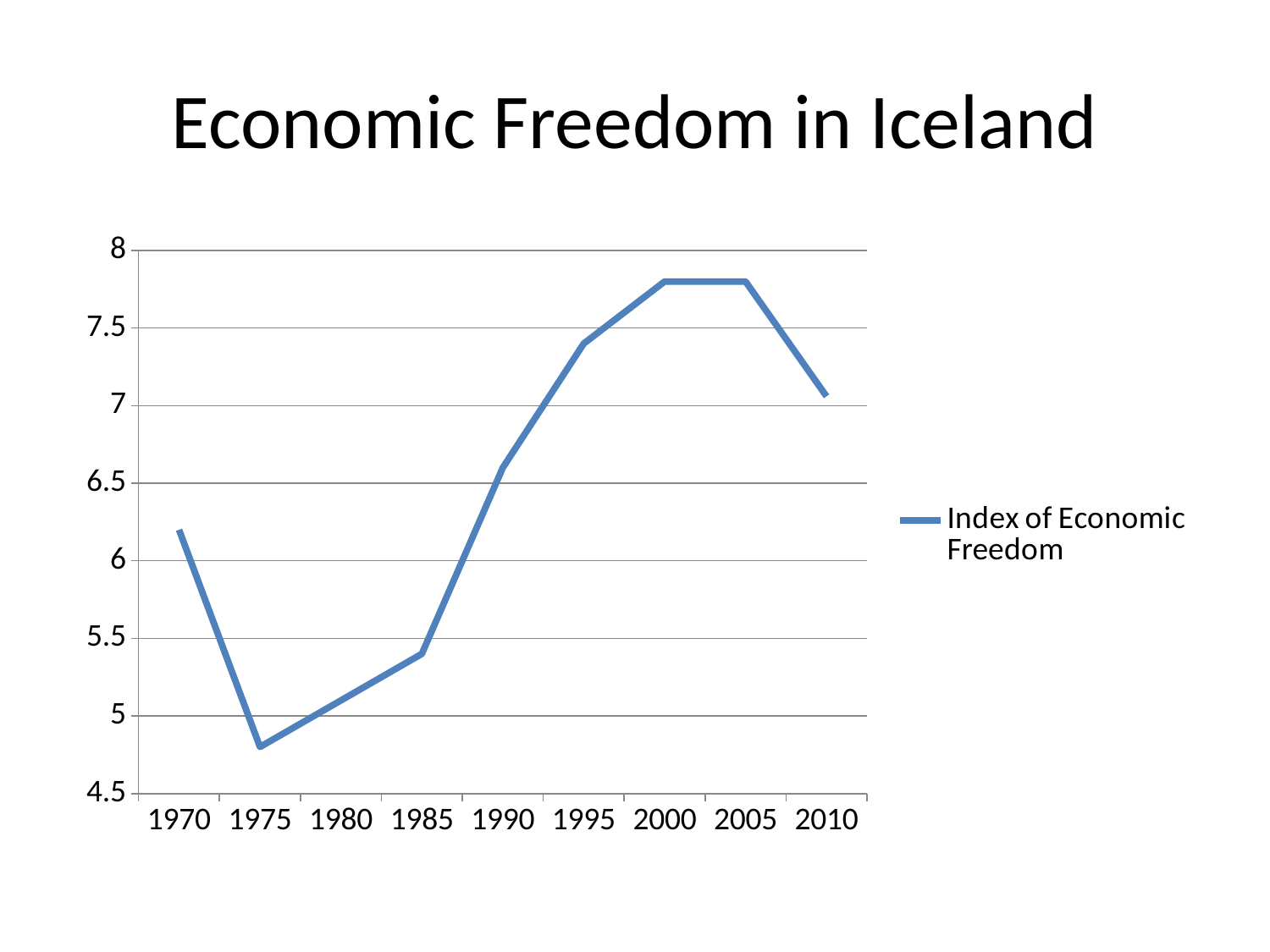
Is the value for 1970 greater or less than 6? greater What is the name of the series shown in the legend? Index of Economic Freedom What is the title of the chart? Economic Freedom in Iceland How many years are plotted along the x axis? 9 Does the Index of Economic Freedom rise or fall between 1975 and 2000? Rise Is the value for 1985 greater or less than 5.5? less Which year has the higher Index of Economic Freedom, 1970 or 2010? 2010 Is the value for 1975 greater or less than 5? less What kind of chart is shown on the slide? Line chart In which year is the Index of Economic Freedom lowest? 1975 How many series does the legend list? 1